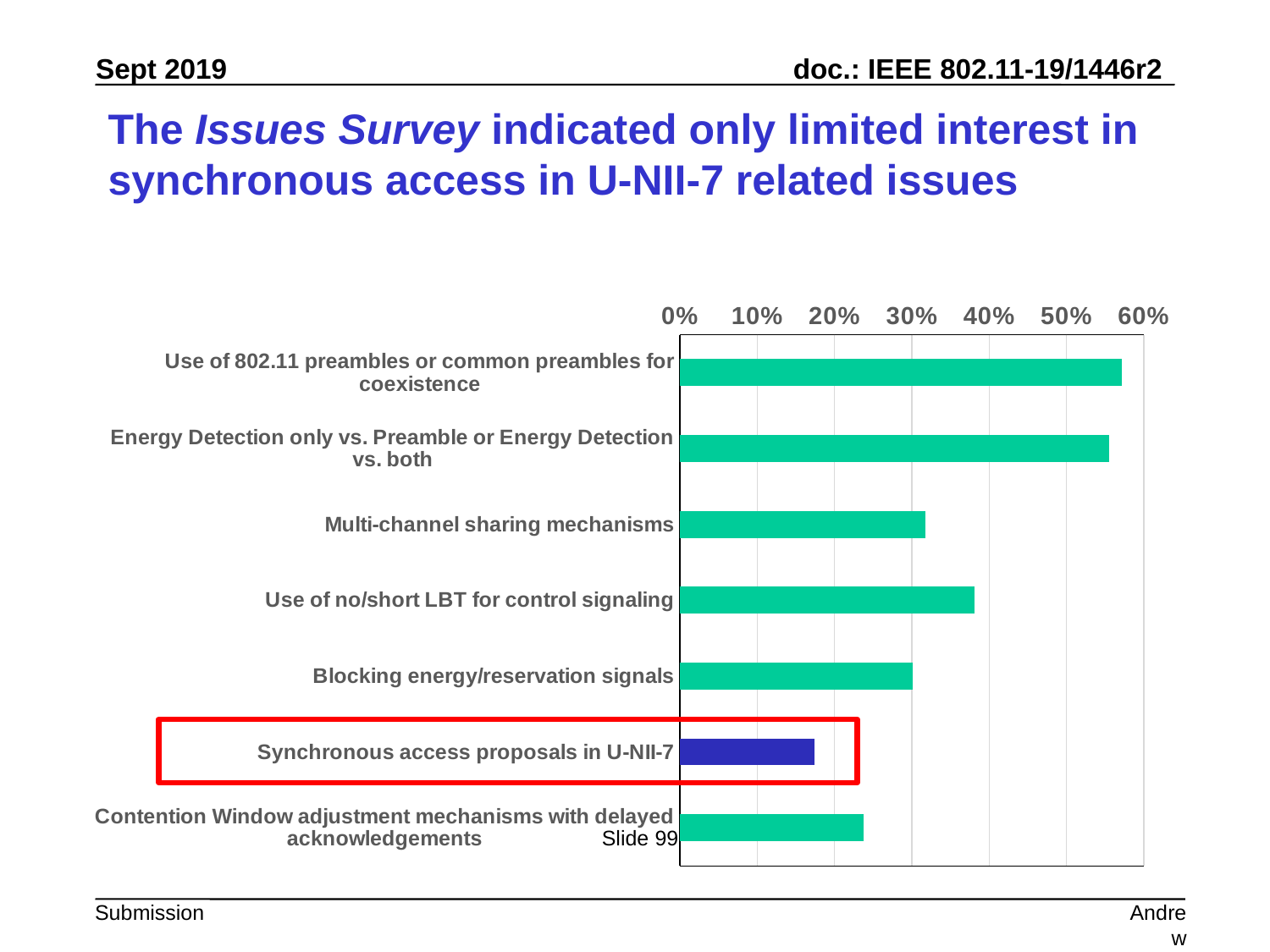
Is the value for Energy Detection only vs. Preamble or Energy Detection vs. both greater or less than 50%? greater Is the value for Use of no/short LBT for control signaling greater or less than 30%? greater Is the value for Contention Window adjustment mechanisms with delayed acknowledgements greater or less than 30%? less Which category has the lowest value in the chart? Synchronous access proposals in U-NII-7 How many categories are plotted in the chart? 7 Which has the larger value: Use of no/short LBT for control signaling or Blocking energy/reservation signals? Use of no/short LBT for control signaling What is the highest value shown on the percentage axis of the chart? 60% What kind of chart is shown on the slide? bar chart Which has the larger value: Multi-channel sharing mechanisms or Contention Window adjustment mechanisms with delayed acknowledgements? Multi-channel sharing mechanisms Which category's bar is drawn in a different colour (dark blue) from the others? Synchronous access proposals in U-NII-7